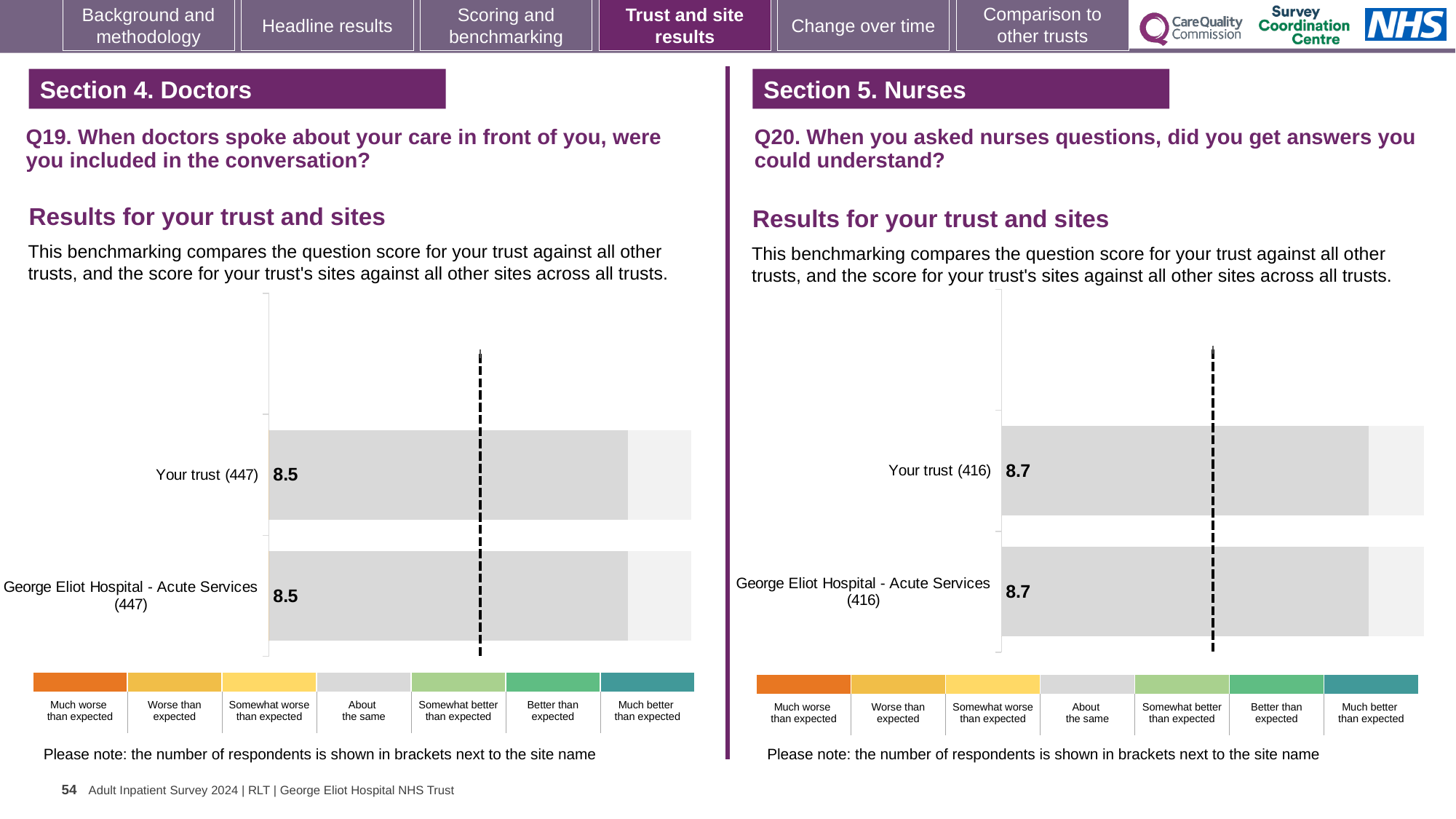
In the Q19 chart on the left, how many respondents are shown in brackets next to Your trust? 447 In the Q20 chart on the right, what is the score for George Eliot Hospital - Acute Services? 8.7 In the Q19 chart on the left, what is the score for Your trust? 8.5 In the Q20 chart on the right, what is the difference between the score for Your trust and the score for George Eliot Hospital - Acute Services? 0 In the Q20 chart on the right, what is the score for Your trust? 8.7 Is the score for Your trust in the Q20 chart on the right larger than the score for Your trust in the Q19 chart on the left? Yes In the Q19 chart on the left, what is the score for George Eliot Hospital - Acute Services? 8.5 In the Q19 chart on the left, what is the difference between the score for Your trust and the score for George Eliot Hospital - Acute Services? 0 In the Q20 chart on the right, how many respondents are shown in brackets next to George Eliot Hospital - Acute Services? 416 How many bars are plotted in the Q19 chart on the left? 2 What type of chart is used for the Q19 results on the left? Bar chart How many bars are plotted in the Q20 chart on the right? 2